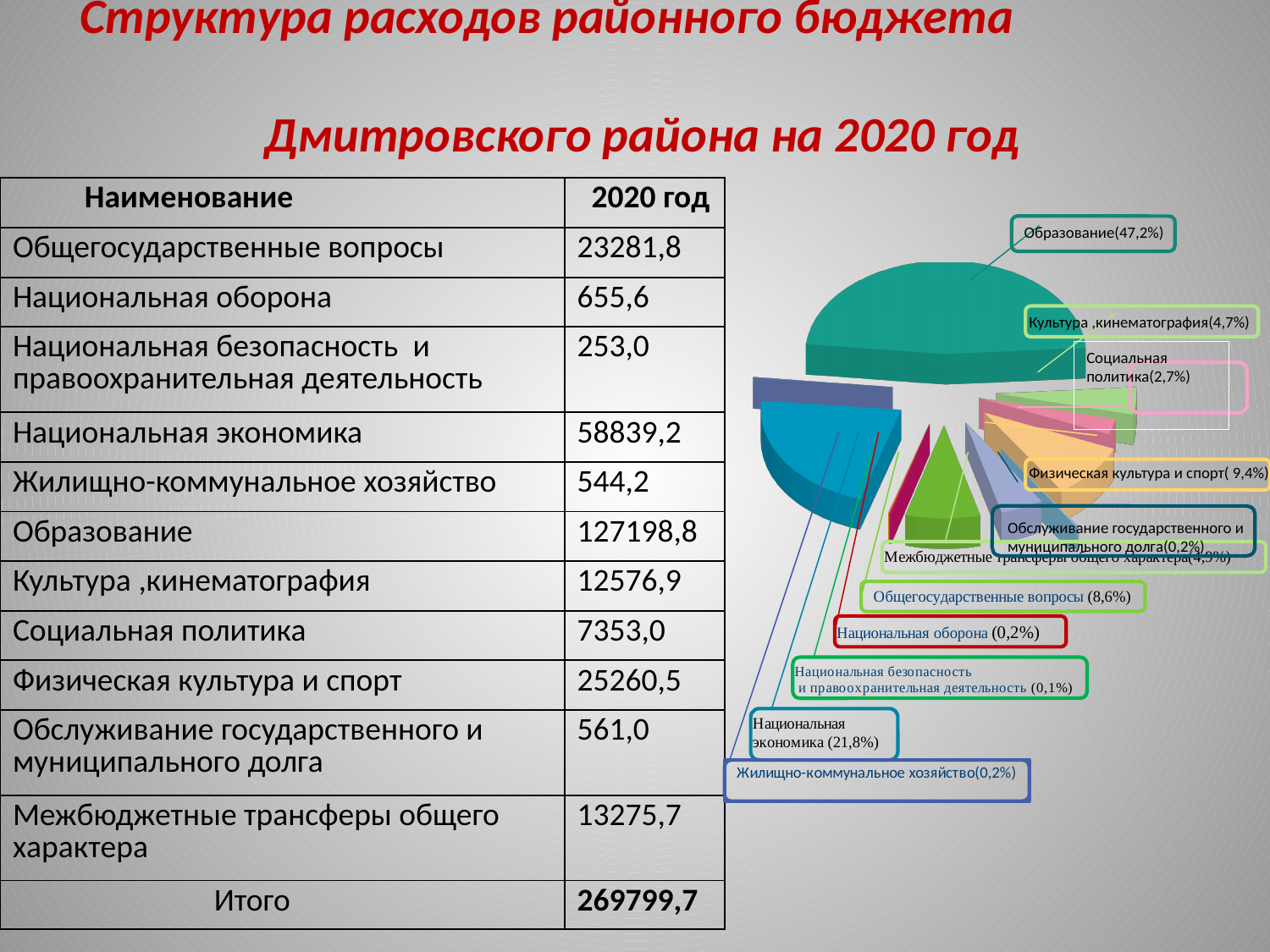
How many slices does the pie chart have? 11 What share of the pie chart does Культура, кинематография have? 4,7% Which category has the smallest slice of the pie chart? Национальная безопасность и правоохранительная деятельность Which category has the largest slice of the pie chart? Образование By how many percentage points does the Образование share exceed the Национальная экономика share in the pie chart? 25,4 What share of the pie chart does Социальная политика have? 2,7% What share of the pie chart does Физическая культура и спорт have? 9,4% What kind of chart is shown on the slide? pie chart Which slice is larger in the pie chart: Национальная экономика or Физическая культура и спорт? Национальная экономика